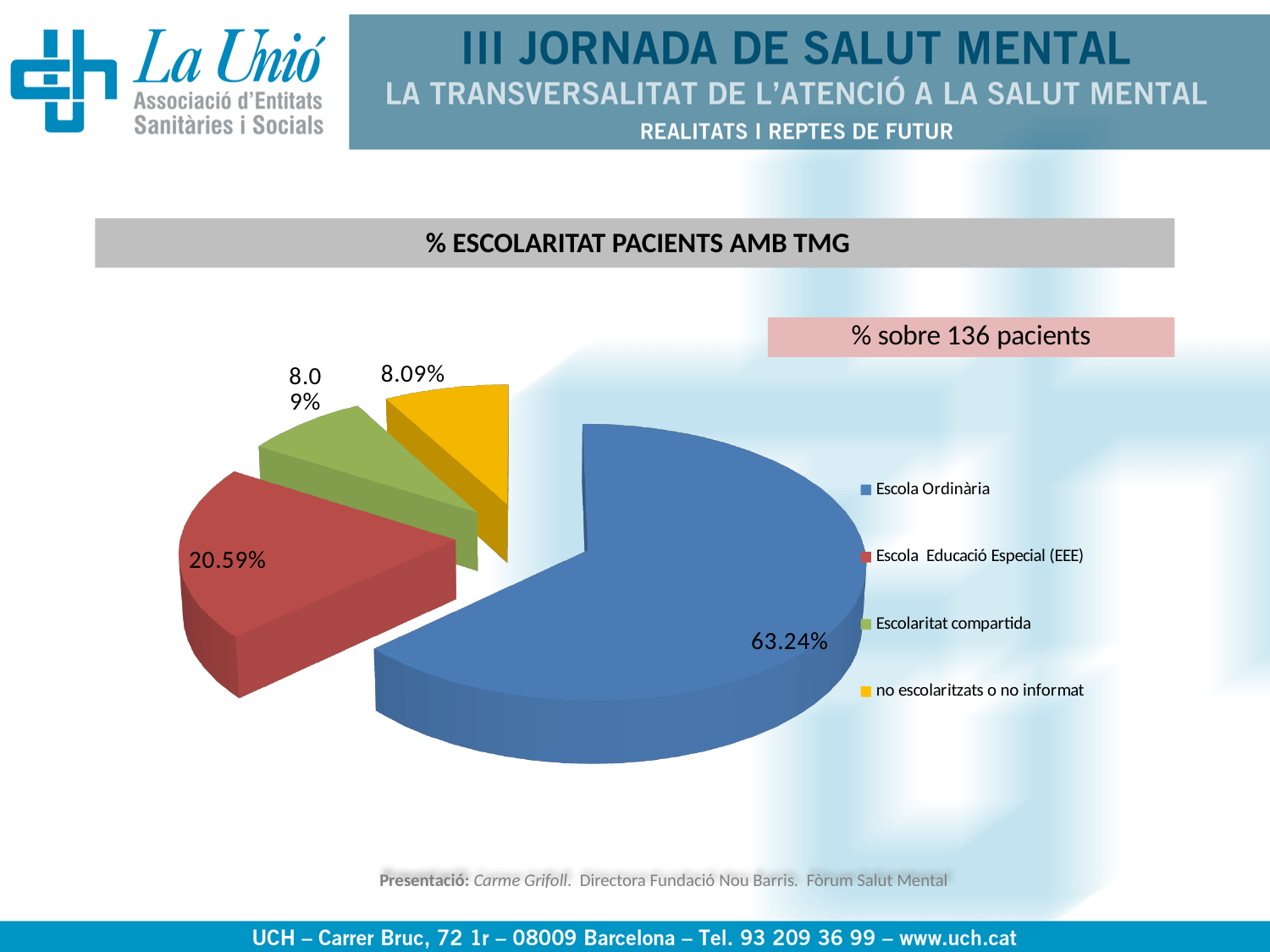
What percentage is shown for no escolaritzats o no informat? 8.09% How many slices does the pie chart have? 4 Which is larger, the share for Escola Educació Especial (EEE) or the share for Escolaritat compartida? Escola Educació Especial (EEE) How many categories does the legend list? 4 Which category has the largest share of the pie? Escola Ordinària What is the title of the chart? % ESCOLARITAT PACIENTS AMB TMG What percentage is shown for Escola Ordinària? 63.24% What is the difference between the shares of Escola Ordinària and Escola Educació Especial (EEE)? 42.65% What percentage is shown for Escolaritat compartida? 8.09% What percentage is shown for Escola Educació Especial (EEE)? 20.59% What kind of chart is shown on the slide? Pie chart According to the note on the slide, how many patients are the percentages based on? 136 pacients